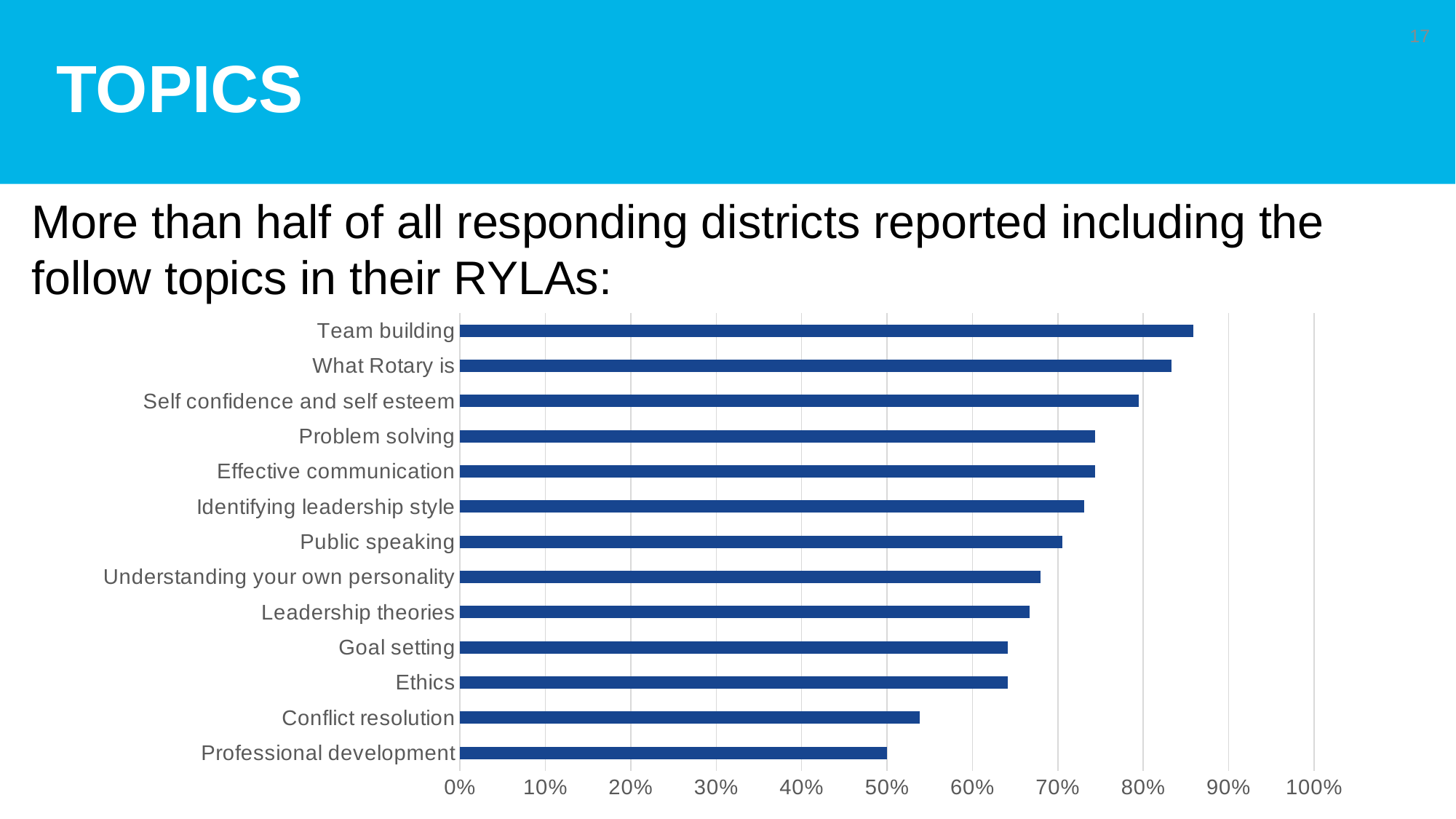
Which has a higher value, Team building or What Rotary is? Team building Which has a higher value, Self confidence and self esteem or Problem solving? Self confidence and self esteem Is the value for Team building greater or less than 80%? greater Is the value for Goal setting greater or less than 60%? greater Which topic has the lowest percentage of districts reporting it? Professional development What is the highest value shown on the horizontal axis of the chart? 100% Is the value for Conflict resolution greater or less than 60%? less What kind of chart is shown on the slide? bar chart Which topic has the highest percentage of districts reporting it? Team building How many topics are listed on the chart? 13